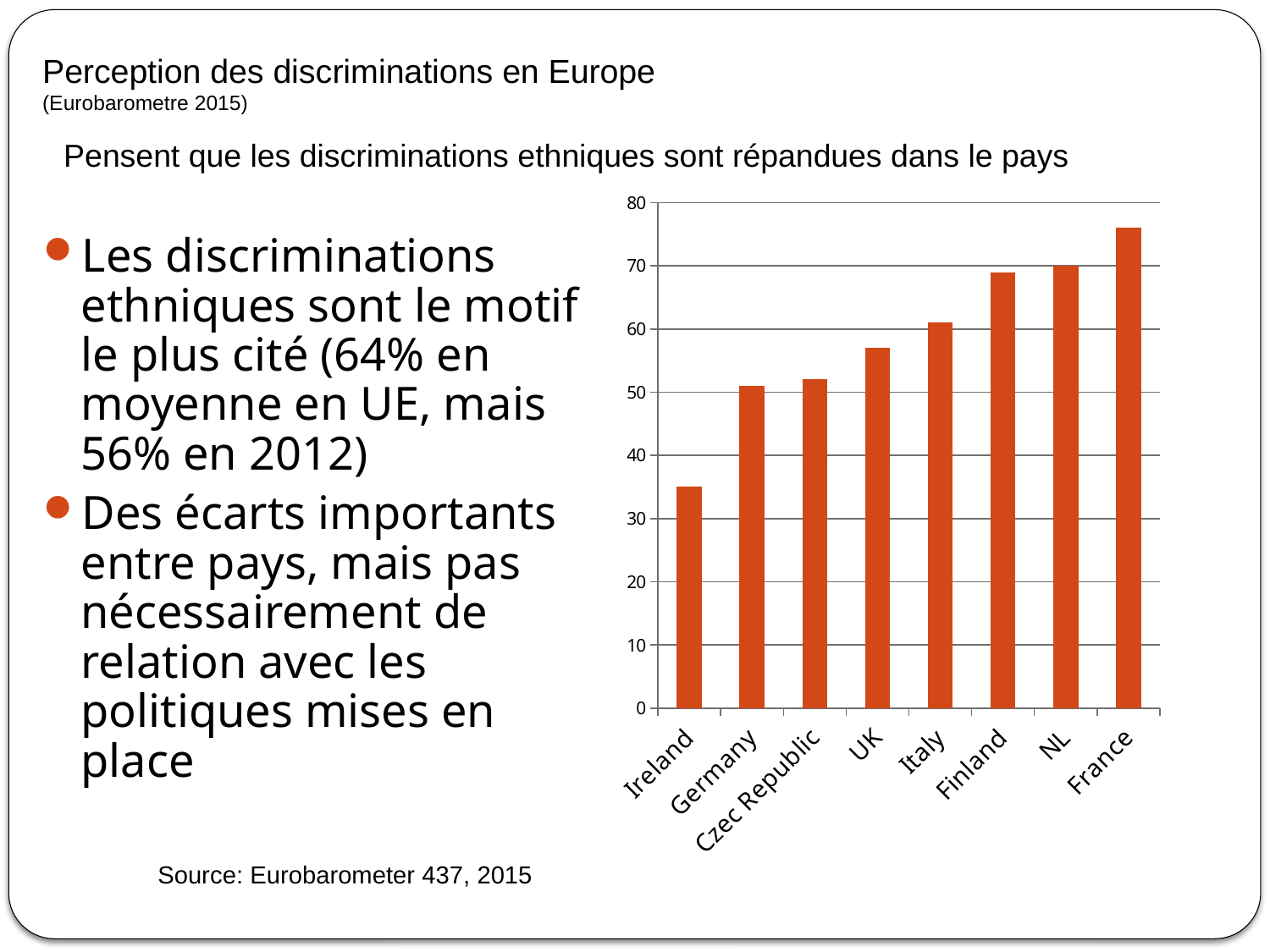
Is the value for UK greater or less than 50? greater Which has a larger value, Italy or Germany? Italy Is the value for Czec Republic greater or less than 60? less Which country has the lowest value in the chart? Ireland What colour are the bars in the chart? orange Is the value for Ireland greater or less than 40? less Which country has the highest value in the chart? France What kind of chart is shown on the slide? bar chart Do the values rise or fall from left to right along the x axis? rise How many countries are shown on the x axis of the chart? 8